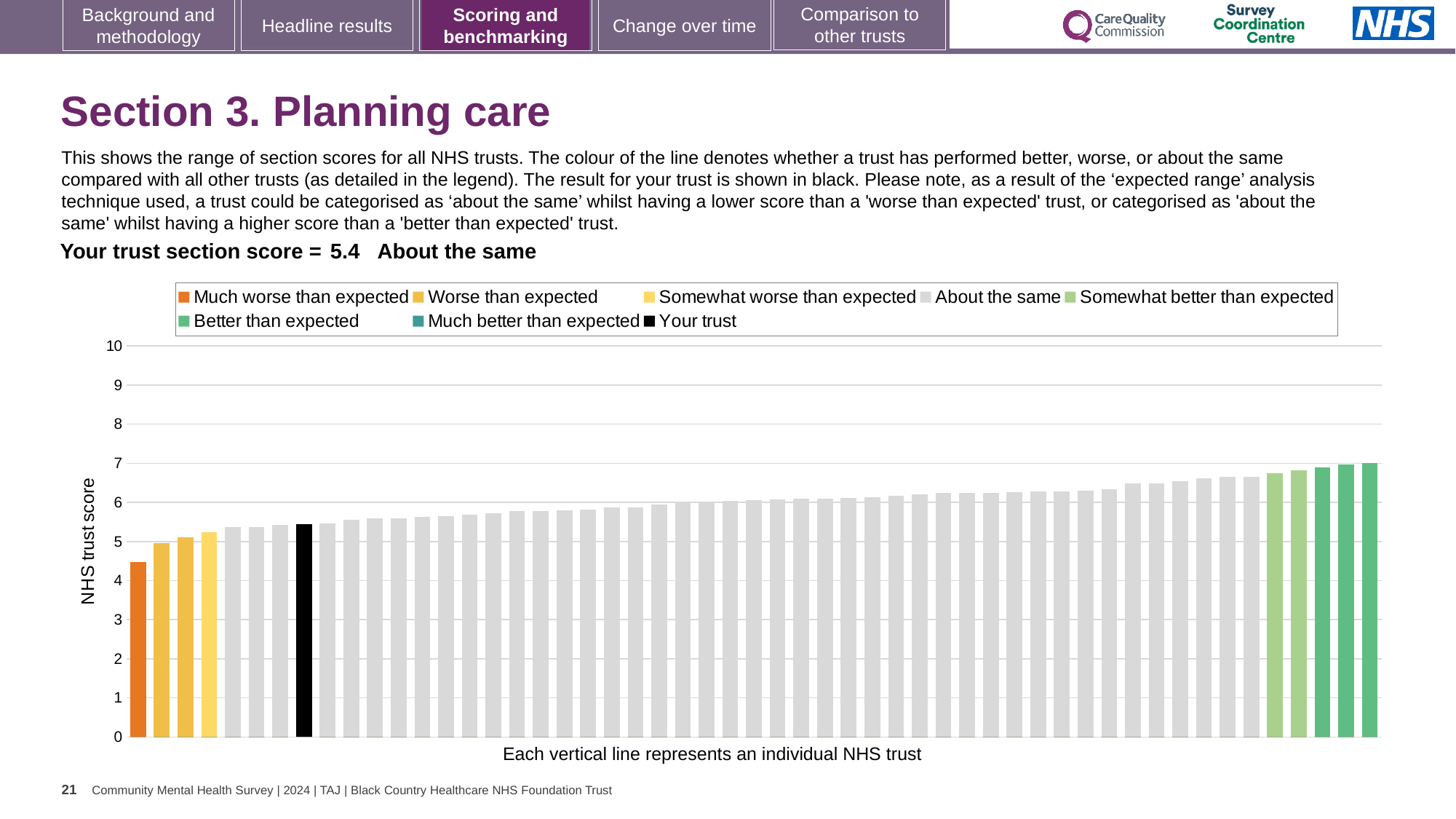
How is your trust's section score categorised compared with other trusts? About the same Which legend category does the shortest bar on the chart belong to? Much worse than expected Which legend category does the tallest bar on the chart belong to? Better than expected What is the section score for your trust shown on the slide? 5.4 Is the value of the black 'Your trust' bar greater or less than 6? less Is the value of the lowest bar (the orange 'Much worse than expected' trust) greater or less than 4? greater Is the value of the tallest bar on the chart greater or less than 6? greater Do the bar values rise or fall from left to right across the chart? rise What is the label on the vertical axis of the chart? NHS trust score How many entries does the chart legend list? 8 What kind of chart is shown on the slide? bar chart